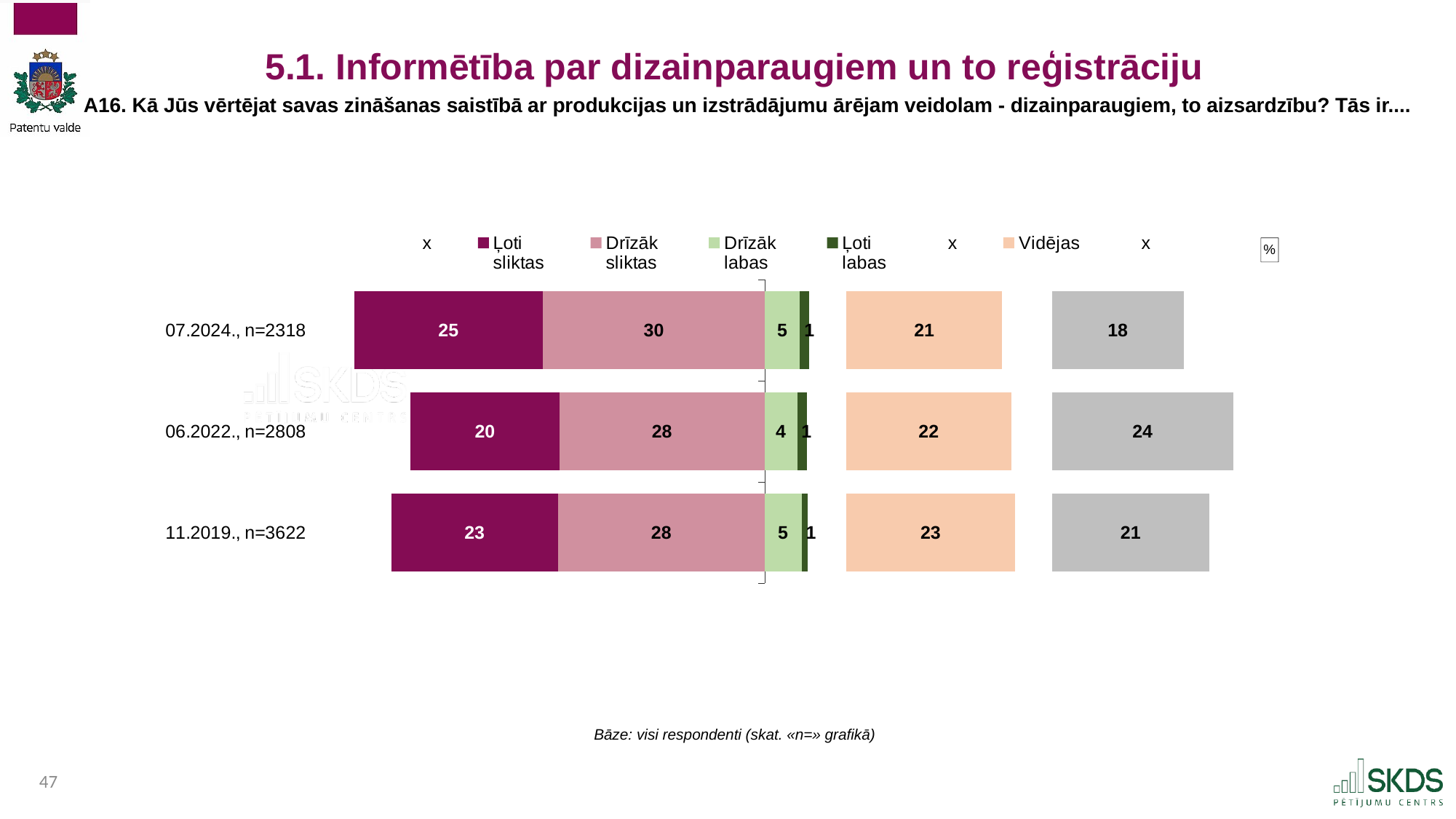
What is the combined value of "Ļoti sliktas" and "Drīzāk sliktas" for 07.2024., n=2318? 55 Which wave has the larger "Vidējas" value: 06.2022., n=2808 or 07.2024., n=2318? 06.2022., n=2808 Which survey wave has the highest value for "Ļoti sliktas"? 07.2024., n=2318 What is the value of "Vidējas" for 11.2019., n=3622? 23 What is the value of "Ļoti labas" for 06.2022., n=2808? 1 How many survey waves are shown in the chart? 3 What is the value of "Drīzāk sliktas" for 06.2022., n=2808? 28 Which survey wave has the lowest value for "Drīzāk labas"? 06.2022., n=2808 How many named categories does the legend list? 5 What kind of chart is shown on the slide? Stacked bar chart What is the value of "Ļoti sliktas" for 07.2024., n=2318? 25 What is the difference between the "Ļoti sliktas" values for 07.2024., n=2318 and 06.2022., n=2808? 5